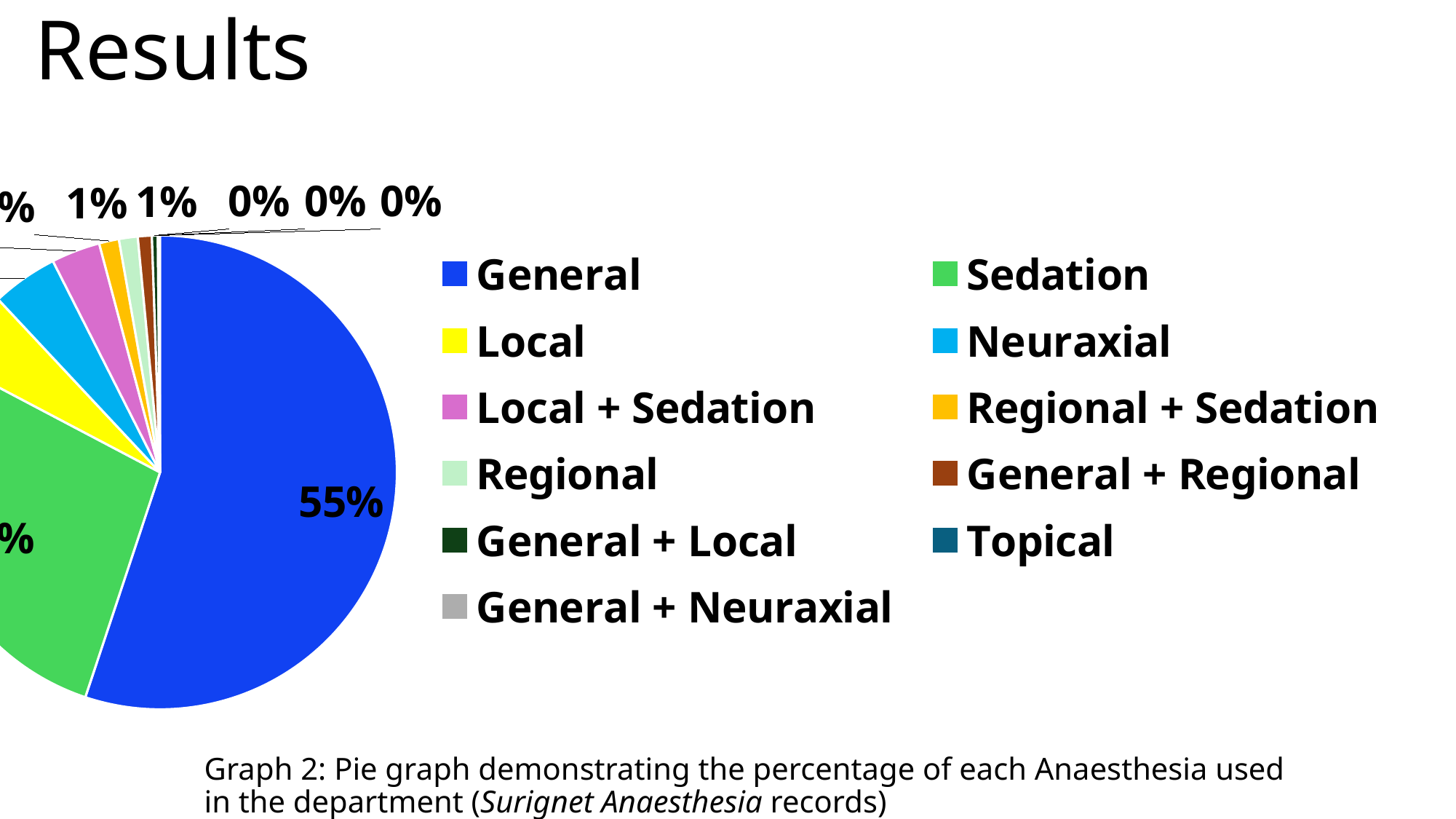
What colour represents General in the pie chart? Blue How many categories does the legend of the pie chart list? 11 What percentage of the pie chart does the General slice represent? 55% Which category has the largest share of the pie chart? General Which has the larger share of the pie chart, Sedation or Local? Sedation Which has the larger share of the pie chart, Sedation or Neuraxial? Sedation According to the caption, what does Graph 2 demonstrate? The percentage of each Anaesthesia used in the department Which has the larger share of the pie chart, General or Sedation? General What kind of chart is shown on the slide? Pie chart